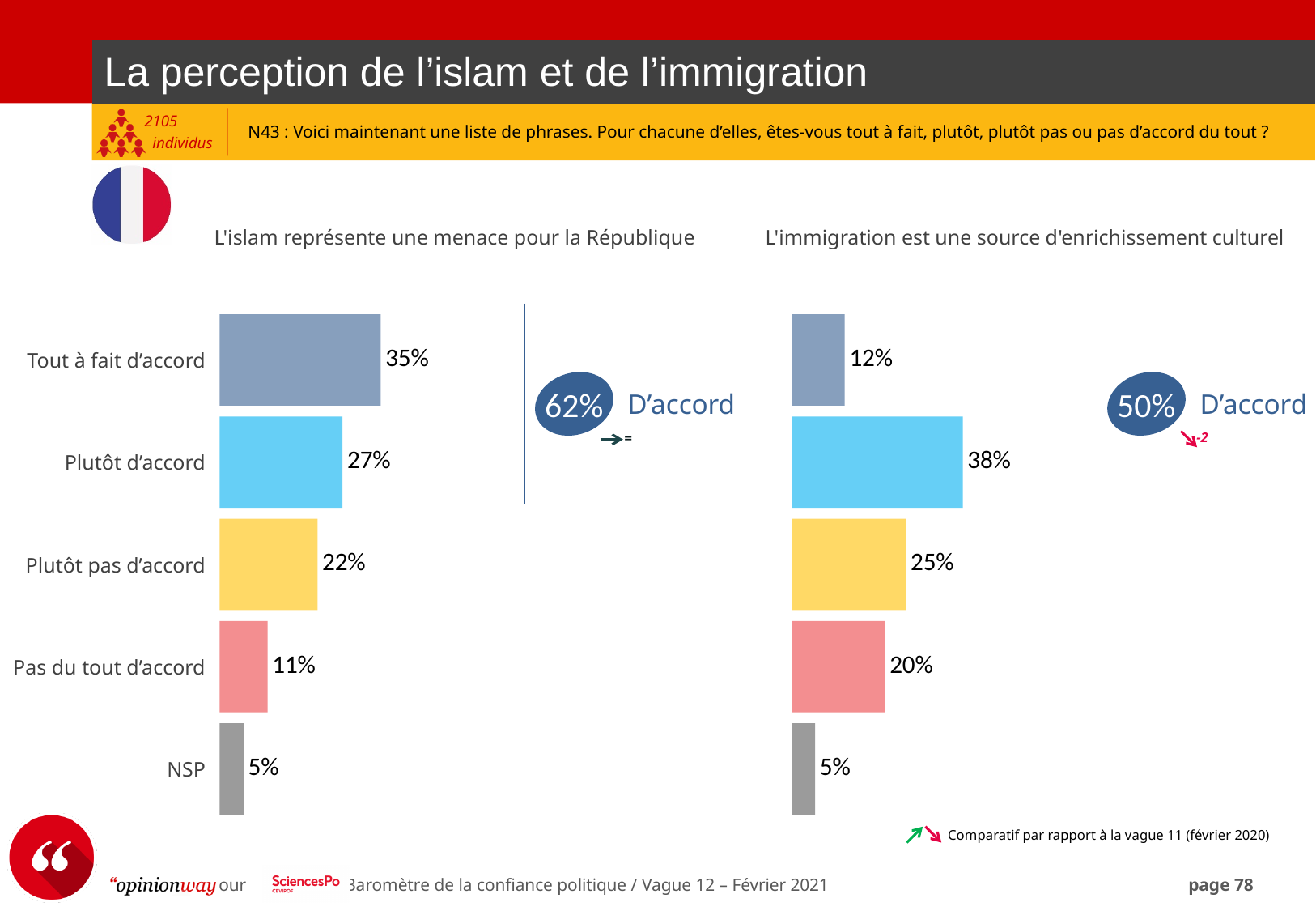
In the chart 'L'islam représente une menace pour la République', which category has the highest value? Tout à fait d'accord In the chart 'L'islam représente une menace pour la République', what is the difference between 'Plutôt d'accord' and 'Pas du tout d'accord'? 16% In the chart 'L'immigration est une source d'enrichissement culturel', which category has the lowest value? NSP What is the total 'D'accord' percentage shown next to the chart 'L'islam représente une menace pour la République'? 62% In the chart 'L'islam représente une menace pour la République', what is the value for 'Tout à fait d'accord'? 35% In the chart 'L'islam représente une menace pour la République', what is the value for 'NSP'? 5% How many categories are shown in the chart 'L'islam représente une menace pour la République'? 5 What kind of chart is used for 'L'immigration est une source d'enrichissement culturel'? Bar chart In the chart 'L'immigration est une source d'enrichissement culturel', what is the value for 'Tout à fait d'accord'? 12% What is the total 'D'accord' percentage shown next to the chart 'L'immigration est une source d'enrichissement culturel'? 50% In the chart 'L'immigration est une source d'enrichissement culturel', which is larger: 'Plutôt pas d'accord' or 'Pas du tout d'accord'? Plutôt pas d'accord In the chart 'L'immigration est une source d'enrichissement culturel', what is the value for 'Plutôt d'accord'? 38%